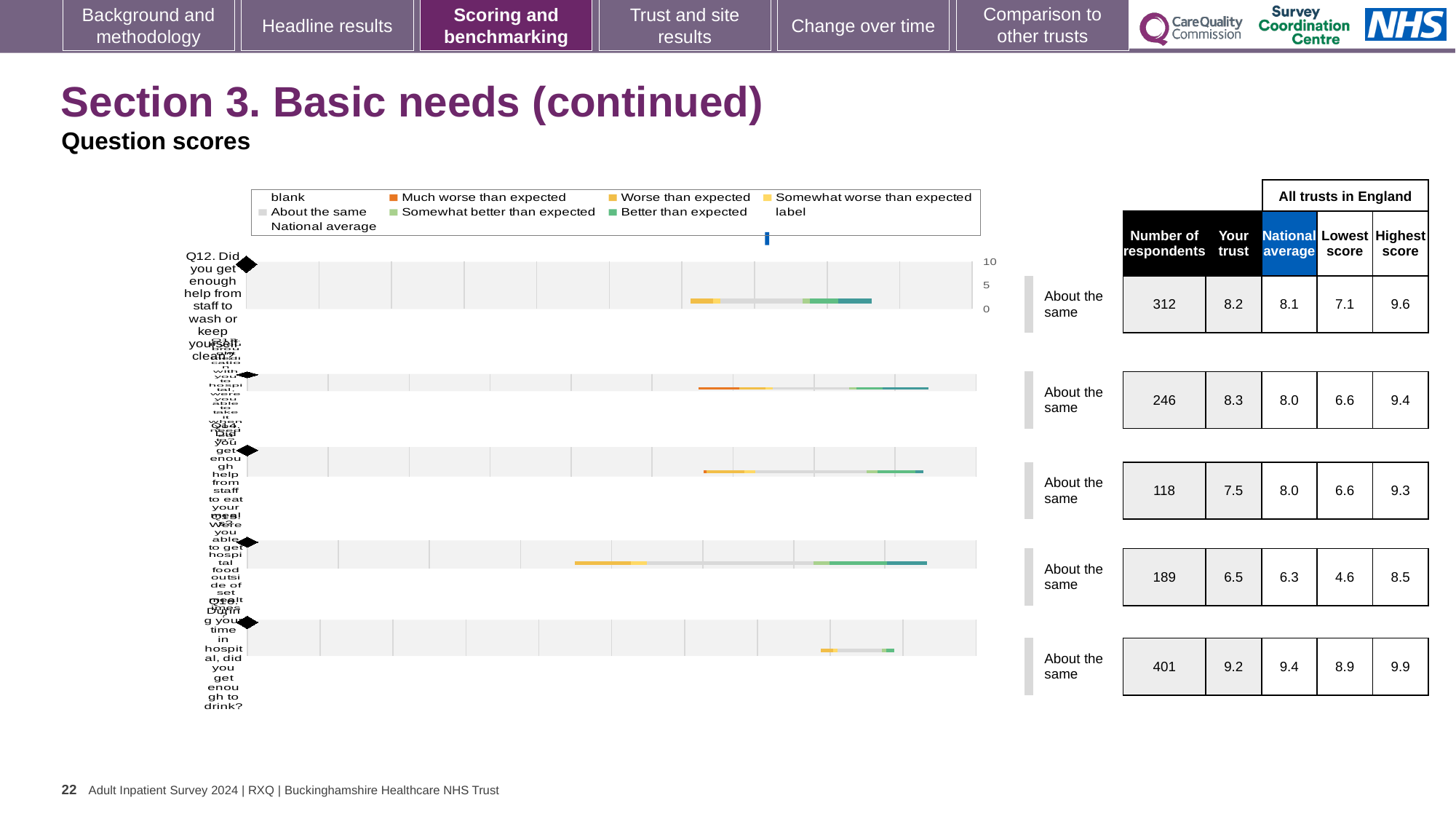
Which question has the lowest 'Your trust' score? Q15 (Were you able to get hospital food outside of set meal times?) What kind of chart is used to show the question scores on this slide? bar chart What is the highest value shown on the chart's score axis? 10 Is the 'Your trust' score for Q14 (Did you get enough help from staff to eat your meals?) higher or lower than the national average? lower What colour in the legend represents 'Much worse than expected'? orange Which question has the highest 'Your trust' score? Q16 (During your time in hospital, did you get enough to drink?) What is the national average score for Q16 (During your time in hospital, did you get enough to drink?)? 9.4 What benchmark category is shown for every question on this slide? About the same How many respondents answered Q16 (During your time in hospital, did you get enough to drink?)? 401 What is the difference between the highest score and the lowest score across all trusts for Q12? 2.5 How many questions (rows) are plotted in the chart? 5 What is the 'Your trust' score for Q12 (Did you get enough help from staff to wash or keep yourself clean?)? 8.2